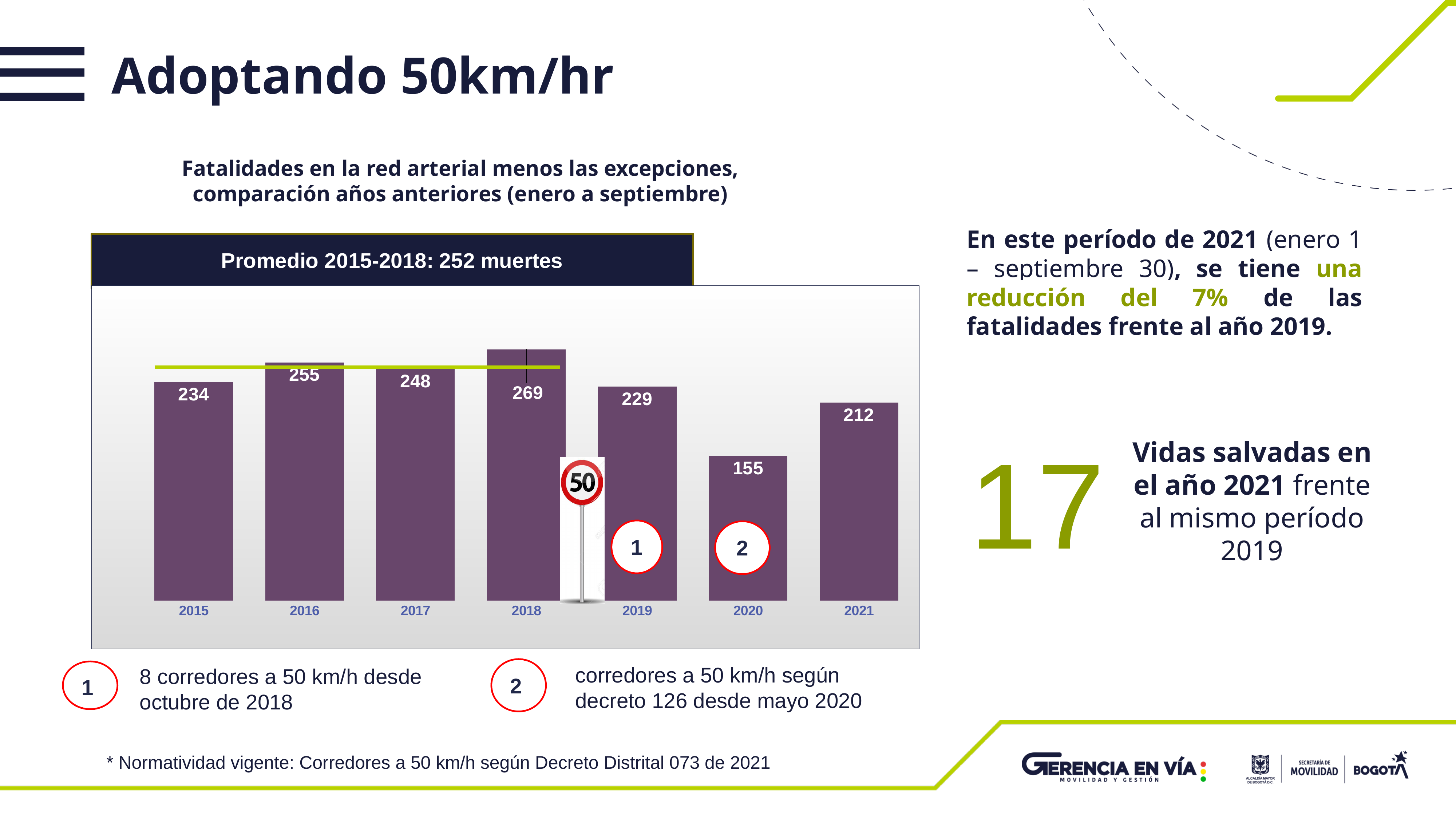
What is the value for 2015? 234 How many years are shown in the chart? 7 Which year has the lowest value? 2020 Which is larger, the value for 2016 or the value for 2017? 2016 What is the value for 2018? 269 Which year has the highest value? 2018 What average for 2015-2018 is stated in the chart's header? 252 muertes What is the value for 2021? 212 What is the difference between the values for 2018 and 2020? 114 What kind of chart is shown? bar chart What is the difference between the values for 2019 and 2021? 17 What is the value for 2020? 155